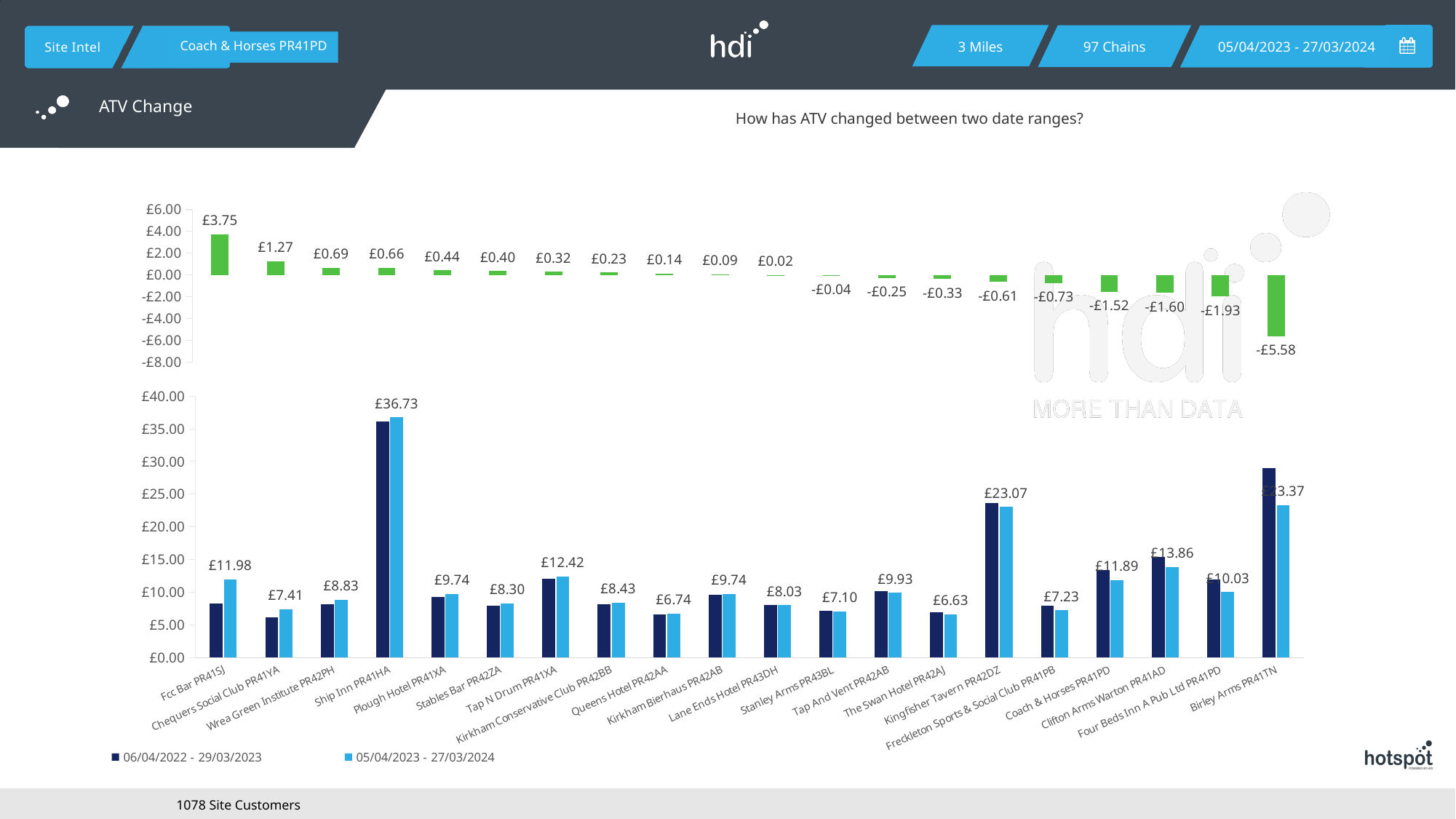
On the top chart (ATV change), which site has the lowest value? Birley Arms PR41TN On the top chart (ATV change), what is the value for Birley Arms PR41TN? -£5.58 On the top chart (ATV change), what is the value for Fcc Bar PR41SJ? £3.75 On the top chart (ATV change), do the values rise or fall moving from left to right along the x axis? fall On the top chart (ATV change), what is the difference between the values for Fcc Bar PR41SJ and Chequers Social Club PR41YA? £2.48 On the bottom chart, what is the value for Ship Inn PR41HA in the 05/04/2023 - 27/03/2024 series? £36.73 How many series does the legend of the bottom chart list? 2 On the bottom chart, what is the value for Kingfisher Tavern PR42DZ in the 05/04/2023 - 27/03/2024 series? £23.07 On the top chart (ATV change), what is the value for Coach & Horses PR41PD? -£1.52 On the bottom chart, which site has the highest value in the 05/04/2023 - 27/03/2024 series? Ship Inn PR41HA On the bottom chart, is the value for Birley Arms PR41TN in the 06/04/2022 - 29/03/2023 series greater or less than £25.00? greater How many sites are shown along the x axis of the bottom chart? 20